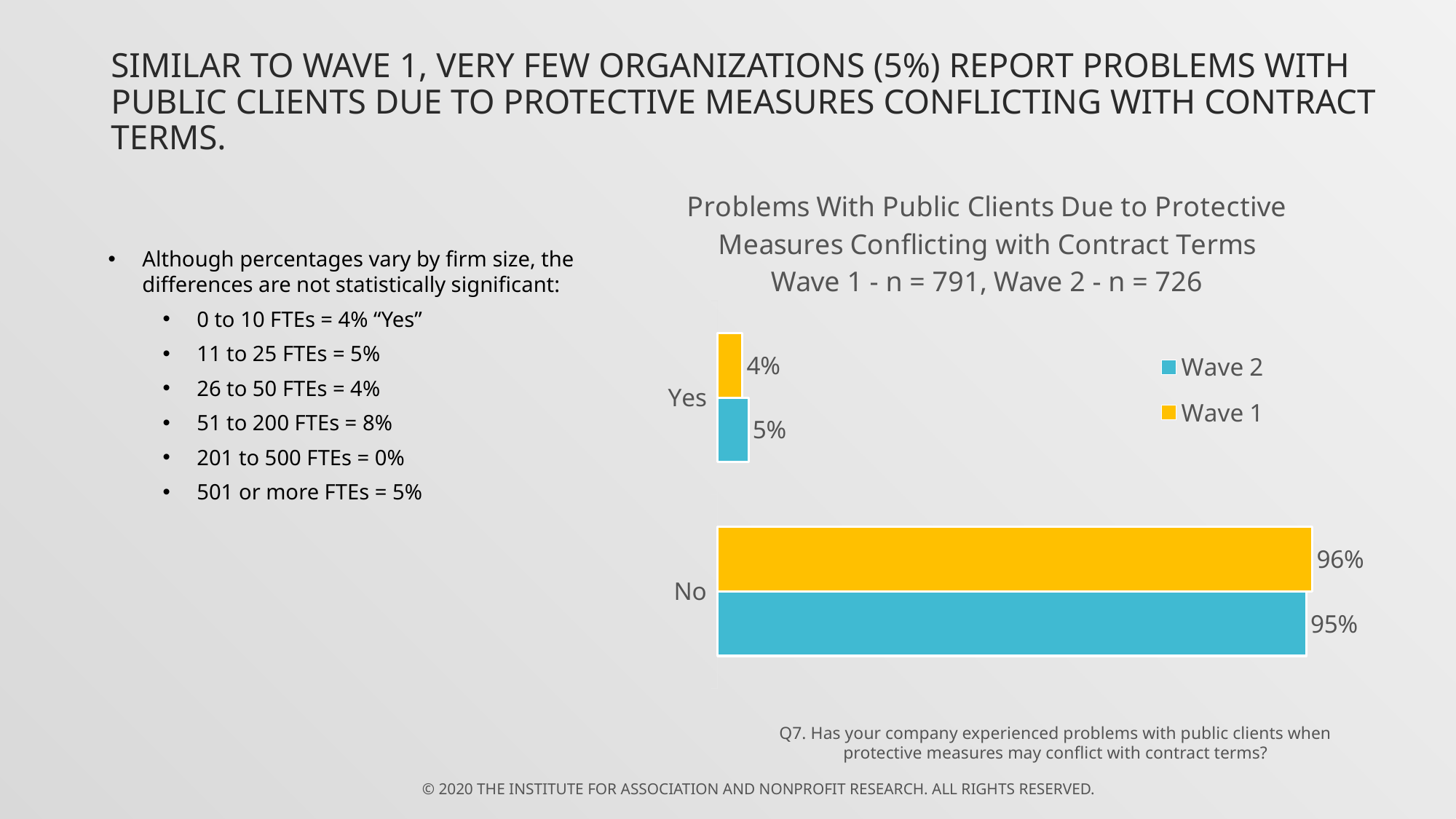
What is the Wave 1 value for "No"? 96% What is the difference between the "No" and "Yes" values in Wave 2? 90% How many series does the legend list? 2 Which category has the lowest value in the Wave 2 series? Yes How many categories are shown on the chart? 2 What is the Wave 2 value for "Yes"? 5% What kind of chart is shown on the slide? Bar chart Which category has the highest value in the Wave 1 series? No What is the Wave 1 value for "Yes"? 4% What is the Wave 2 value for "No"? 95% Which is larger: the Wave 1 value for "Yes" or the Wave 2 value for "Yes"? Wave 2 What is the difference between the Wave 1 and Wave 2 values for "No"? 1%